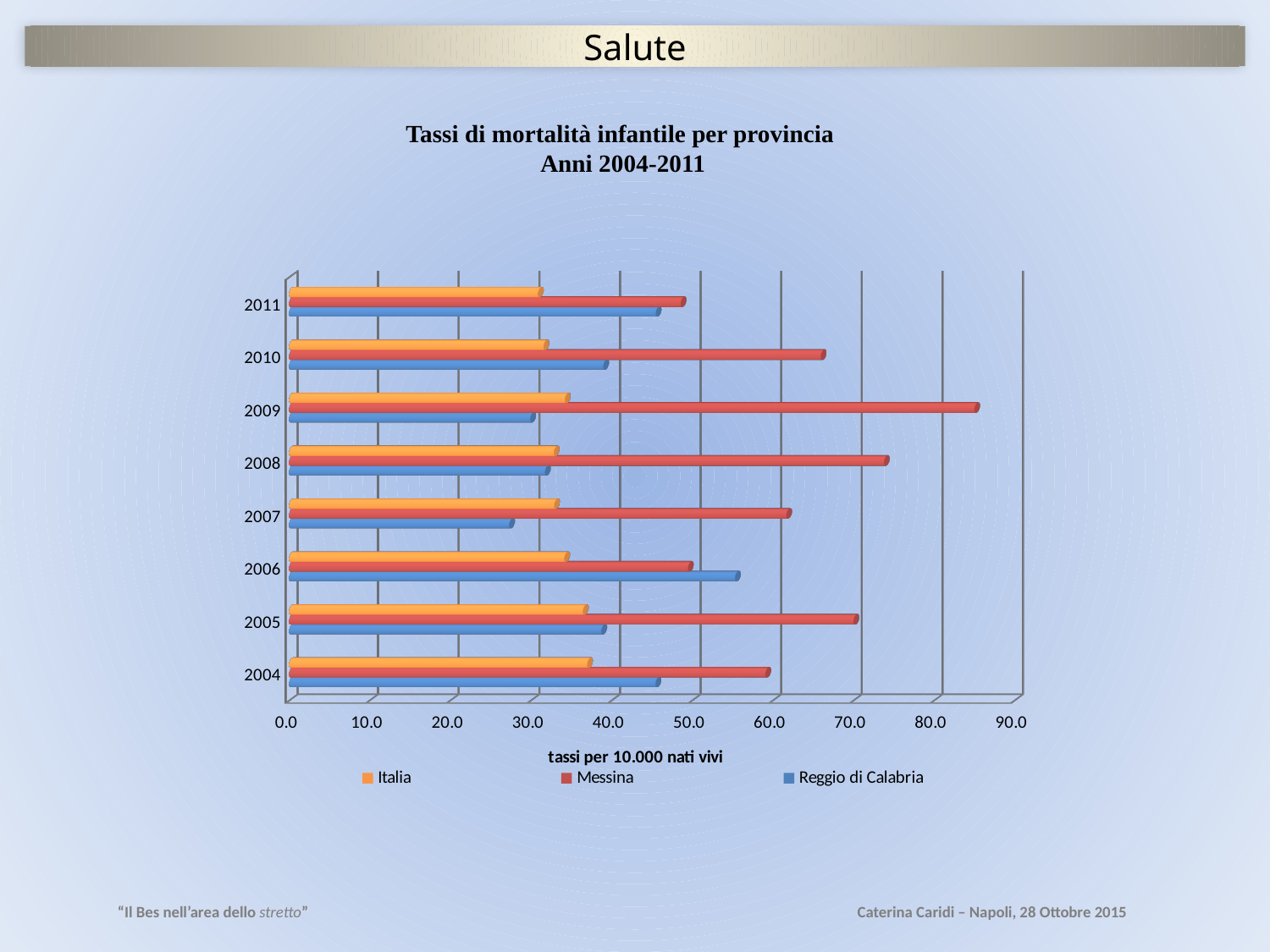
What is the label of the horizontal axis? tassi per 10.000 nati vivi In 2006, which is larger: the value for Messina or for Reggio di Calabria? Reggio di Calabria How many series does the legend list? 3 Is the value for Messina in 2010 greater or less than 60.0? greater Is the value for Messina in 2009 greater or less than 80.0? greater In 2009, which is larger: the value for Messina or for Italia? Messina In which year is the value for Reggio di Calabria highest? 2006 Is the value for Italia in 2004 greater or less than 40.0? less In which year is the value for Messina highest? 2009 How many years are shown on the vertical axis? 8 What kind of chart is shown on the slide? bar chart